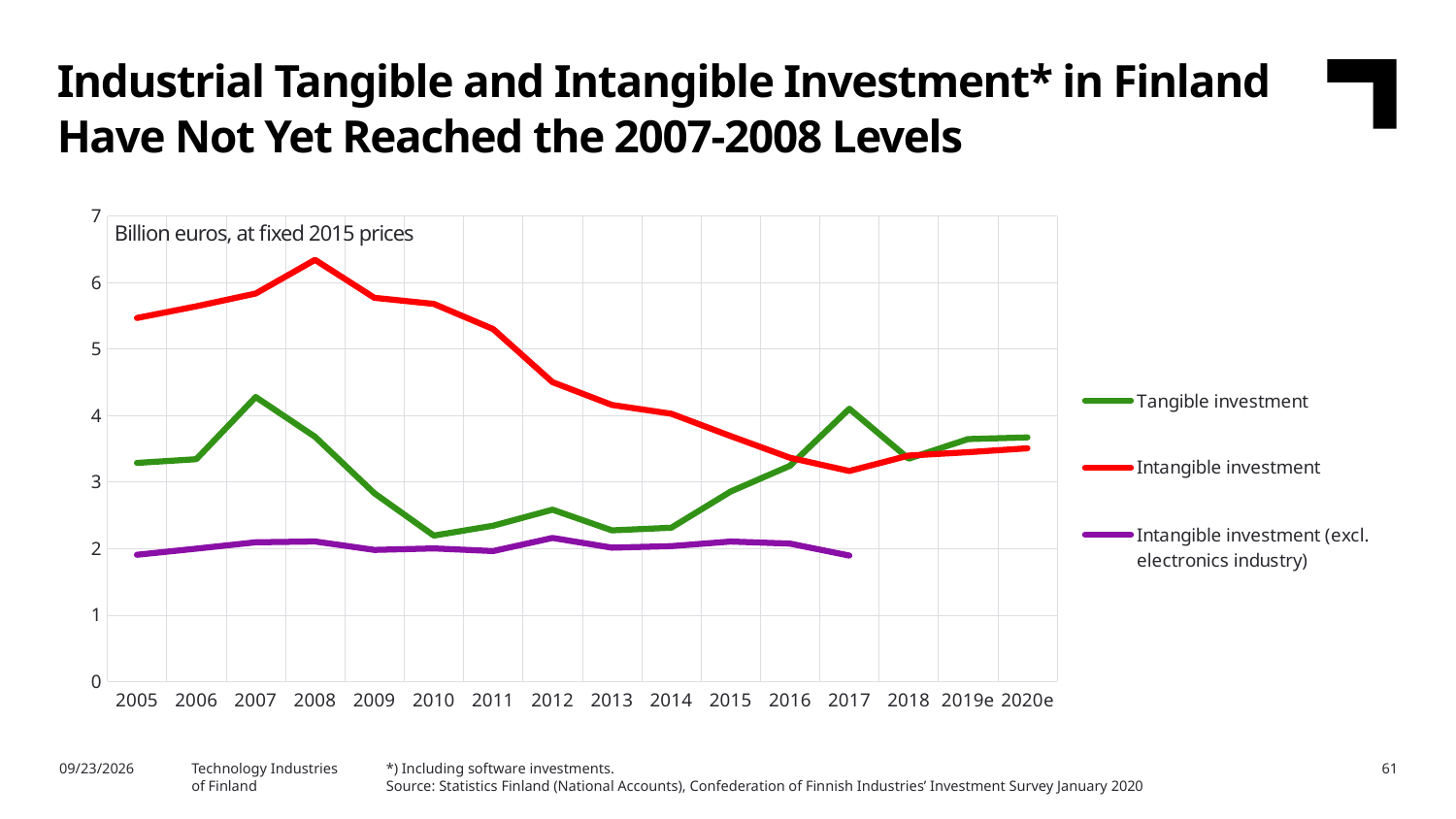
How many years are shown on the x axis? 16 Is the value for Tangible investment in 2010 greater or less than 3? less In which year does Intangible investment reach its highest value? 2008 Is the value for Intangible investment (excl. electronics industry) in 2012 greater or less than 3? less What kind of chart is shown on the slide? line chart In 2005, which is larger: Tangible investment or Intangible investment? Intangible investment Is the value for Intangible investment in 2008 greater or less than 6? greater In 2017, which is larger: Tangible investment or Intangible investment? Tangible investment What unit label is shown inside the chart area? Billion euros, at fixed 2015 prices Does Intangible investment rise or fall between 2008 and 2017? fall How many series does the legend list? 3 In which year does Intangible investment reach its lowest value? 2017